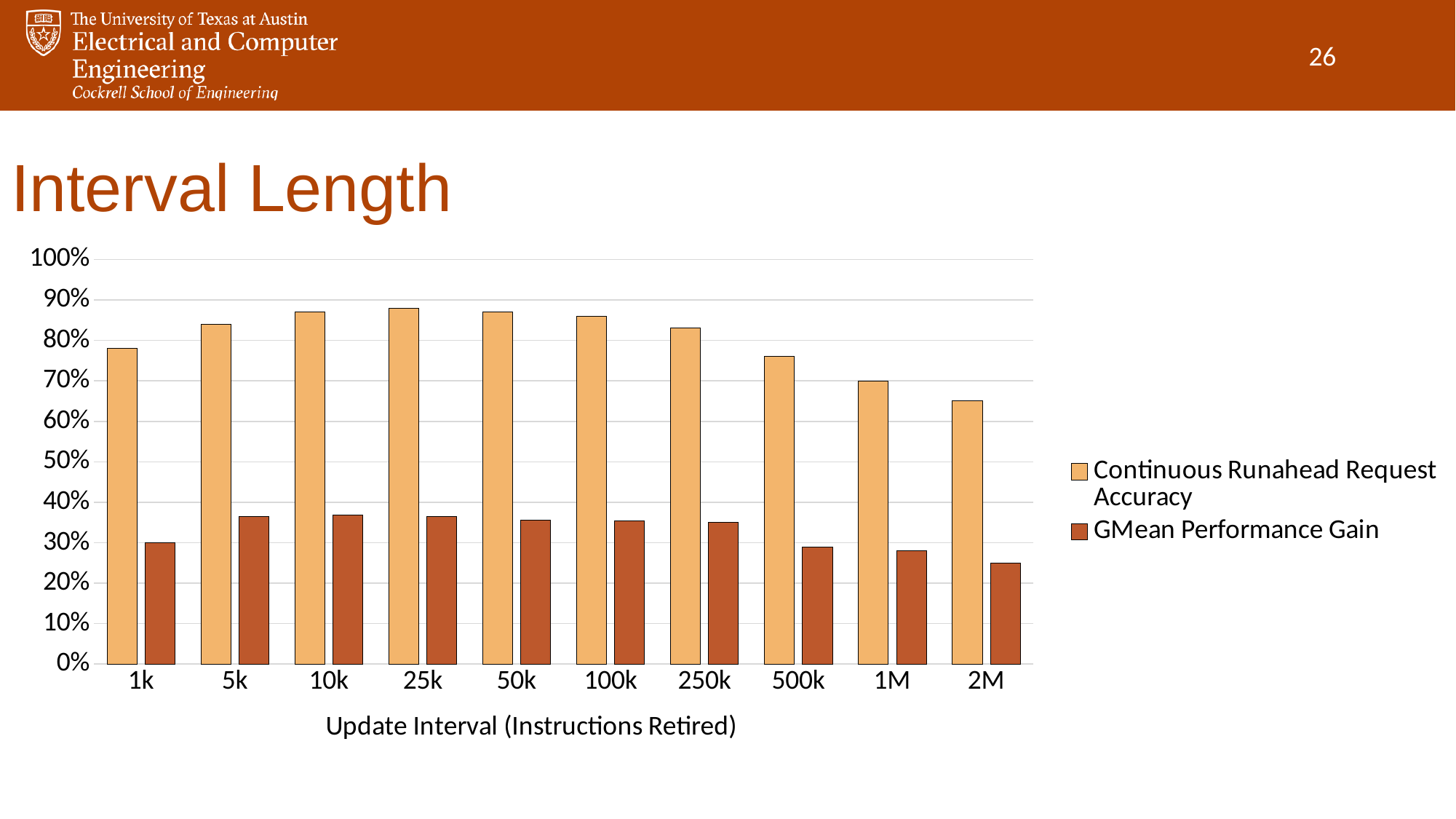
Which is larger, the Continuous Runahead Request Accuracy for 5k or for 2M? 5k Is the GMean Performance Gain for 10k greater or less than 30%? greater What is the title of the x axis? Update Interval (Instructions Retired) Is the GMean Performance Gain for 2M greater or less than 30%? less Is the Continuous Runahead Request Accuracy for 25k greater or less than 80%? greater How many series does the legend list? 2 Which update interval has the lowest Continuous Runahead Request Accuracy? 2M How many update interval categories are shown on the x axis? 10 From 250k to 2M, does the Continuous Runahead Request Accuracy rise or fall? fall What kind of chart is shown on the slide? bar chart Which update interval has the lowest GMean Performance Gain? 2M